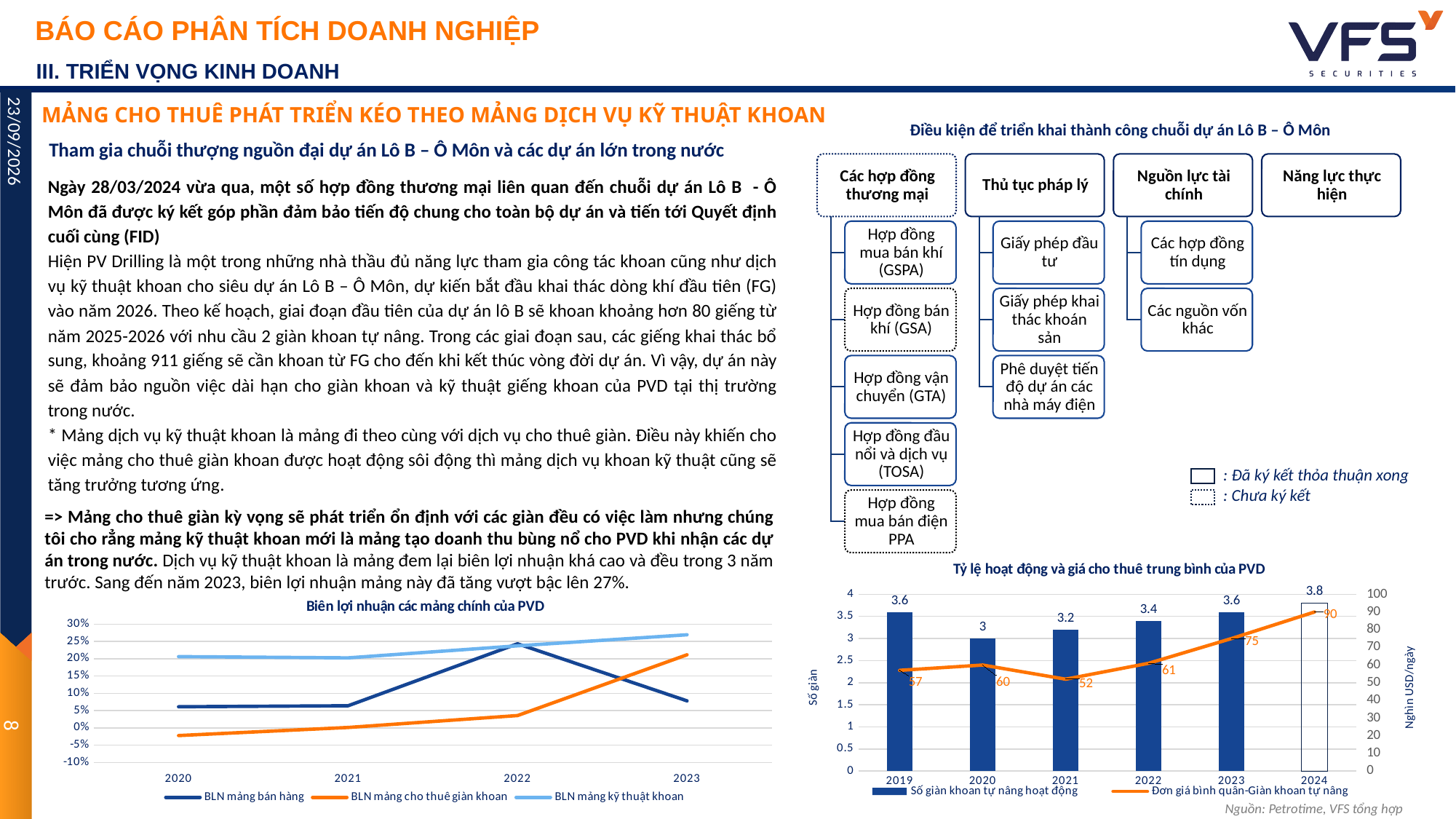
In the chart 'Tỷ lệ hoạt động và giá cho thuê trung bình của PVD', which year has the highest value for 'Đơn giá bình quân-Giàn khoan tự nâng'? 2024 In the chart 'Tỷ lệ hoạt động và giá cho thuê trung bình của PVD', what is the value of 'Số giàn khoan tự nâng hoạt động' for 2019? 3.6 In the chart 'Tỷ lệ hoạt động và giá cho thuê trung bình của PVD', which year has the lowest value for 'Số giàn khoan tự nâng hoạt động'? 2020 In the chart 'Tỷ lệ hoạt động và giá cho thuê trung bình của PVD', what is the value of 'Đơn giá bình quân-Giàn khoan tự nâng' for 2023? 75 What kind of chart is 'Biên lợi nhuận các mảng chính của PVD'? line chart In the chart 'Tỷ lệ hoạt động và giá cho thuê trung bình của PVD', what is the difference between the 'Đơn giá bình quân-Giàn khoan tự nâng' values for 2024 and 2023? 15 In the chart 'Tỷ lệ hoạt động và giá cho thuê trung bình của PVD', what is the value of 'Đơn giá bình quân-Giàn khoan tự nâng' for 2021? 52 In the chart 'Tỷ lệ hoạt động và giá cho thuê trung bình của PVD', how many years are shown on the x axis? 6 In the chart 'Biên lợi nhuận các mảng chính của PVD', how many series does the legend list? 3 In the chart 'Tỷ lệ hoạt động và giá cho thuê trung bình của PVD', how many series does the legend list? 2 In the chart 'Biên lợi nhuận các mảng chính của PVD', does the 'BLN mảng kỹ thuật khoan' series rise or fall from 2020 to 2023? rise In the chart 'Biên lợi nhuận các mảng chính của PVD', is the value of 'BLN mảng cho thuê giàn khoan' for 2020 greater or less than 0%? less